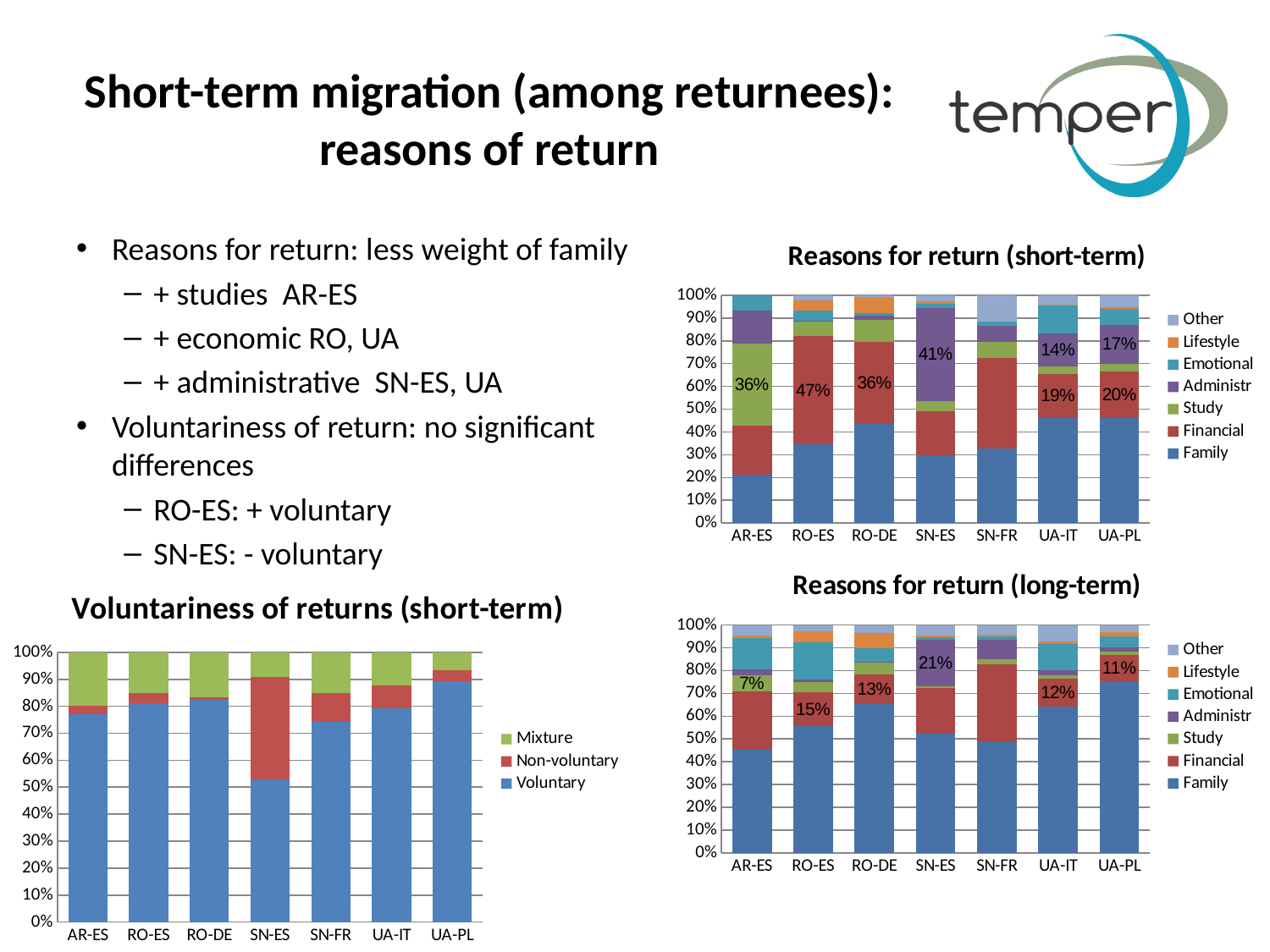
In the 'Voluntariness of returns (short-term)' chart, which category has the lowest Voluntary share? SN-ES In the 'Reasons for return (short-term)' chart, what is the value of the Administr segment for SN-ES? 41% In the 'Reasons for return (long-term)' chart, what is the value of the Administr segment for SN-ES? 21% What kind of chart is the 'Voluntariness of returns (short-term)' chart? Stacked bar chart In the 'Reasons for return (short-term)' chart, what is the value of the Study segment for AR-ES? 36% In the 'Reasons for return (long-term)' chart, what is the value of the Financial segment for RO-ES? 15% How many categories are shown on the x axis of the 'Voluntariness of returns (short-term)' chart? 7 How many series does the legend of the 'Voluntariness of returns (short-term)' chart list? 3 In the 'Reasons for return (short-term)' chart, which has the larger Financial segment, RO-ES or RO-DE? RO-ES In the 'Reasons for return (short-term)' chart, what is the value of the Financial segment for RO-ES? 47% In the 'Reasons for return (short-term)' chart, what is the difference between the Financial and Emotional segments for UA-IT? 5 percentage points In the 'Voluntariness of returns (short-term)' chart, is the Voluntary value for SN-ES greater or less than 60%? less